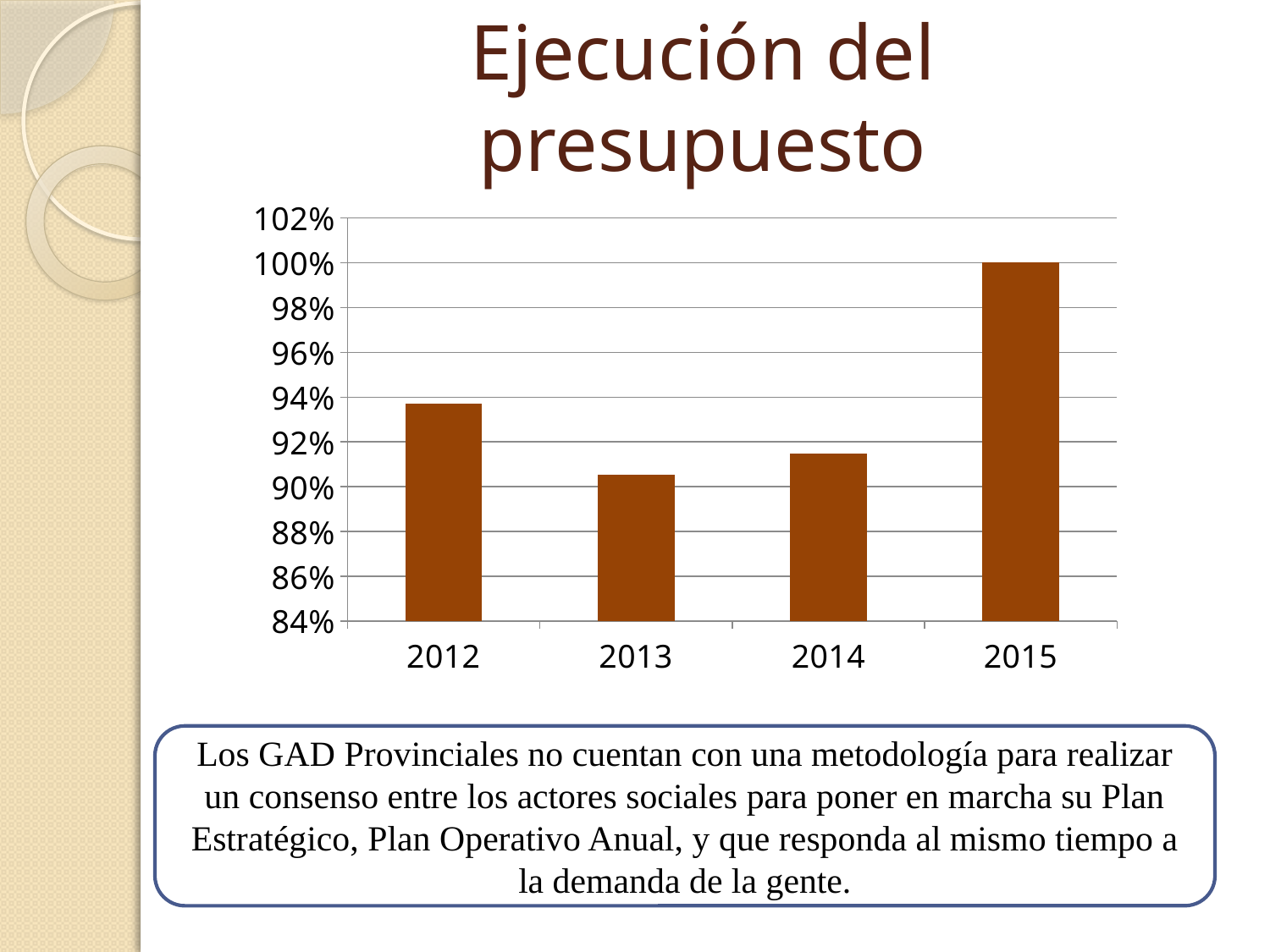
What is the value for 2015 in the chart? 100% What colour are the bars in the chart? Brown Do the values rise or fall from 2013 to 2015? rise Which year has the larger value, 2012 or 2014? 2012 Is the value for 2013 greater or less than 92%? less What kind of chart is shown on the slide? Bar chart Is the value for 2014 greater or less than 90%? greater How many years are shown on the x axis of the chart? 4 Which year has the highest value in the chart? 2015 Is the value for 2012 greater or less than 92%? greater What is the title of the chart on the slide? Ejecución del presupuesto Which year has the lowest value in the chart? 2013